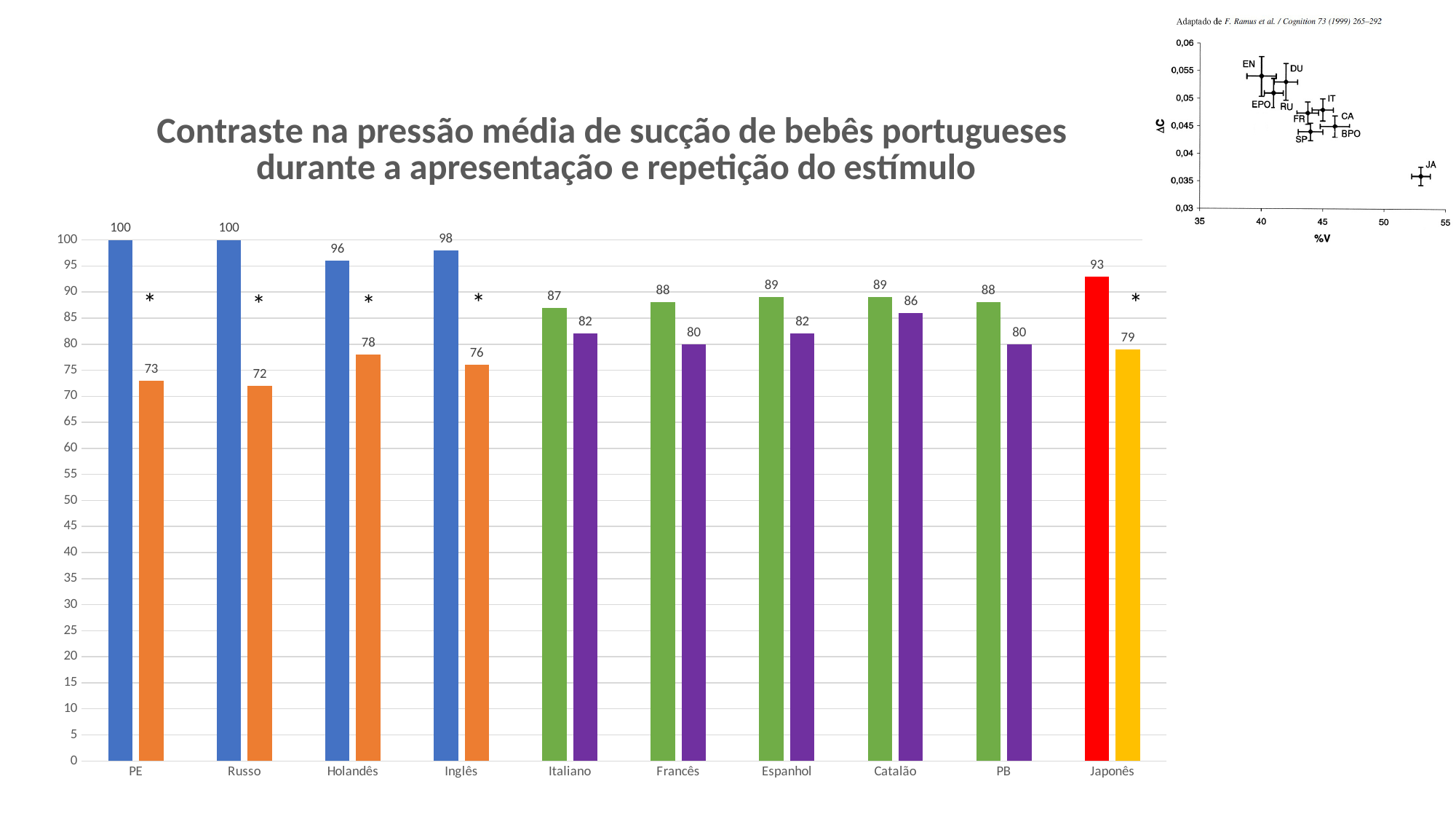
In the bar chart, which is larger: the first bar for Inglês or the first bar for Holandês? Inglês What is the title of the large bar chart? Contraste na pressão média de sucção de bebês portugueses durante a apresentação e repetição do estímulo What kind of chart is the large chart on the slide? Bar chart In the bar chart, what is the value of the second (right) bar for Japonês? 79 In the bar chart, what is the value of the second (right) bar for Catalão? 86 In the bar chart, which category has the highest second (right) bar? Catalão In the bar chart, what is the value of the first (left) bar for Holandês? 96 In the bar chart, what is the difference between the first and second bars for PE? 27 In the small chart in the top-right corner, which labelled point has the lowest ΔC value? JA In the bar chart, what is the difference between the first and second bars for Russo? 28 How many language categories are shown on the x axis of the bar chart? 10 In the bar chart, which category has the lowest second (right) bar? Russo